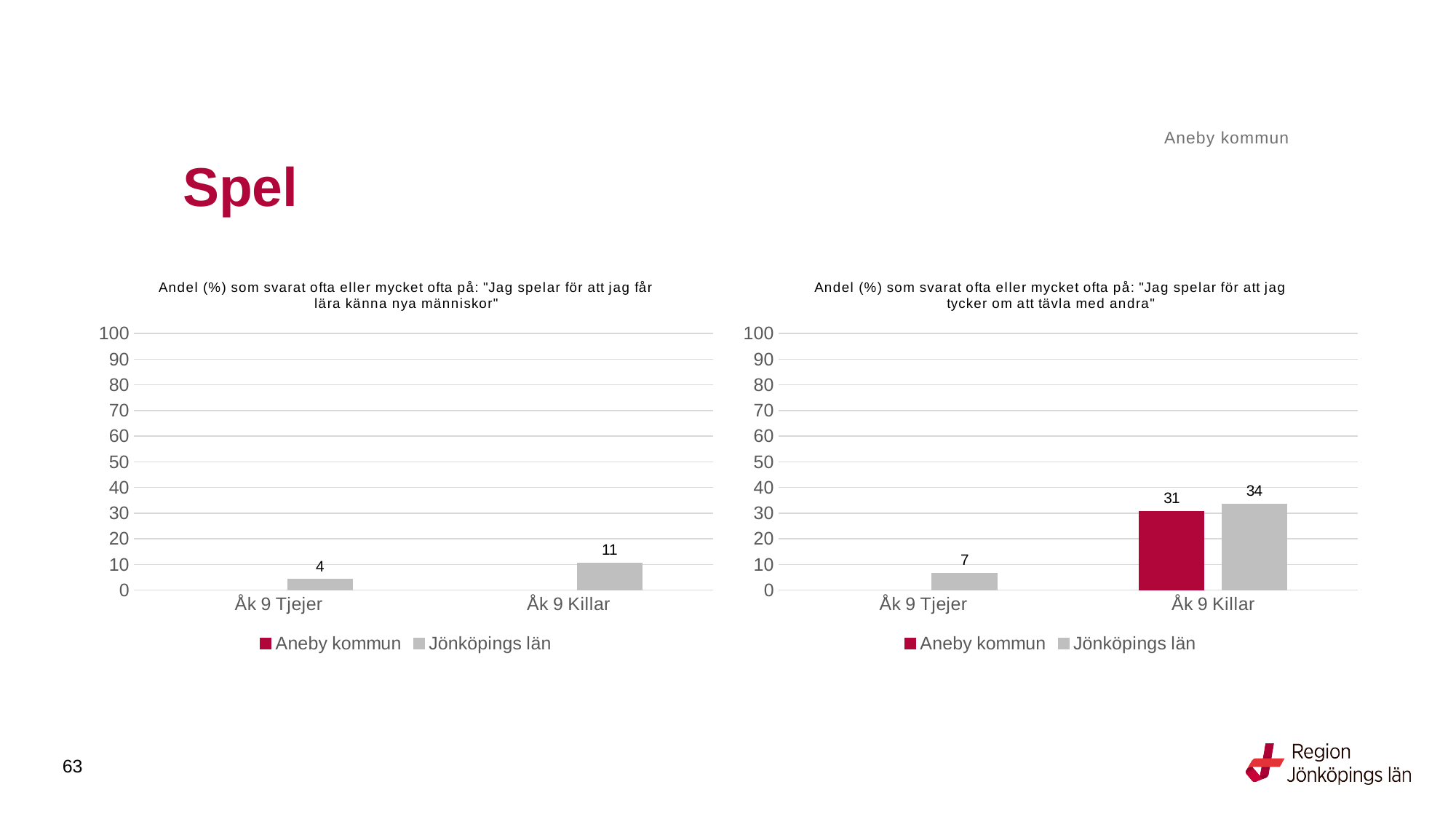
In the left chart, what is the difference between the Jönköpings län values for Åk 9 Killar and Åk 9 Tjejer? 7 What kind of chart is the left chart? Bar chart In the right chart, what is the value for Aneby kommun for Åk 9 Killar? 31 In the right chart, what is the value for Jönköpings län for Åk 9 Tjejer? 7 In the right chart, which is larger for Åk 9 Killar: Aneby kommun or Jönköpings län? Jönköpings län How many categories are shown on the x axis of the right chart? 2 In the right chart, what is the difference between Jönköpings län and Aneby kommun for Åk 9 Killar? 3 In the right chart, what is the value for Jönköpings län for Åk 9 Killar? 34 In the left chart, what is the value for Jönköpings län for Åk 9 Killar? 11 How many series does the legend of the right chart list? 2 In the left chart, what is the value for Jönköpings län for Åk 9 Tjejer? 4 In the right chart, which category has the highest Jönköpings län value? Åk 9 Killar